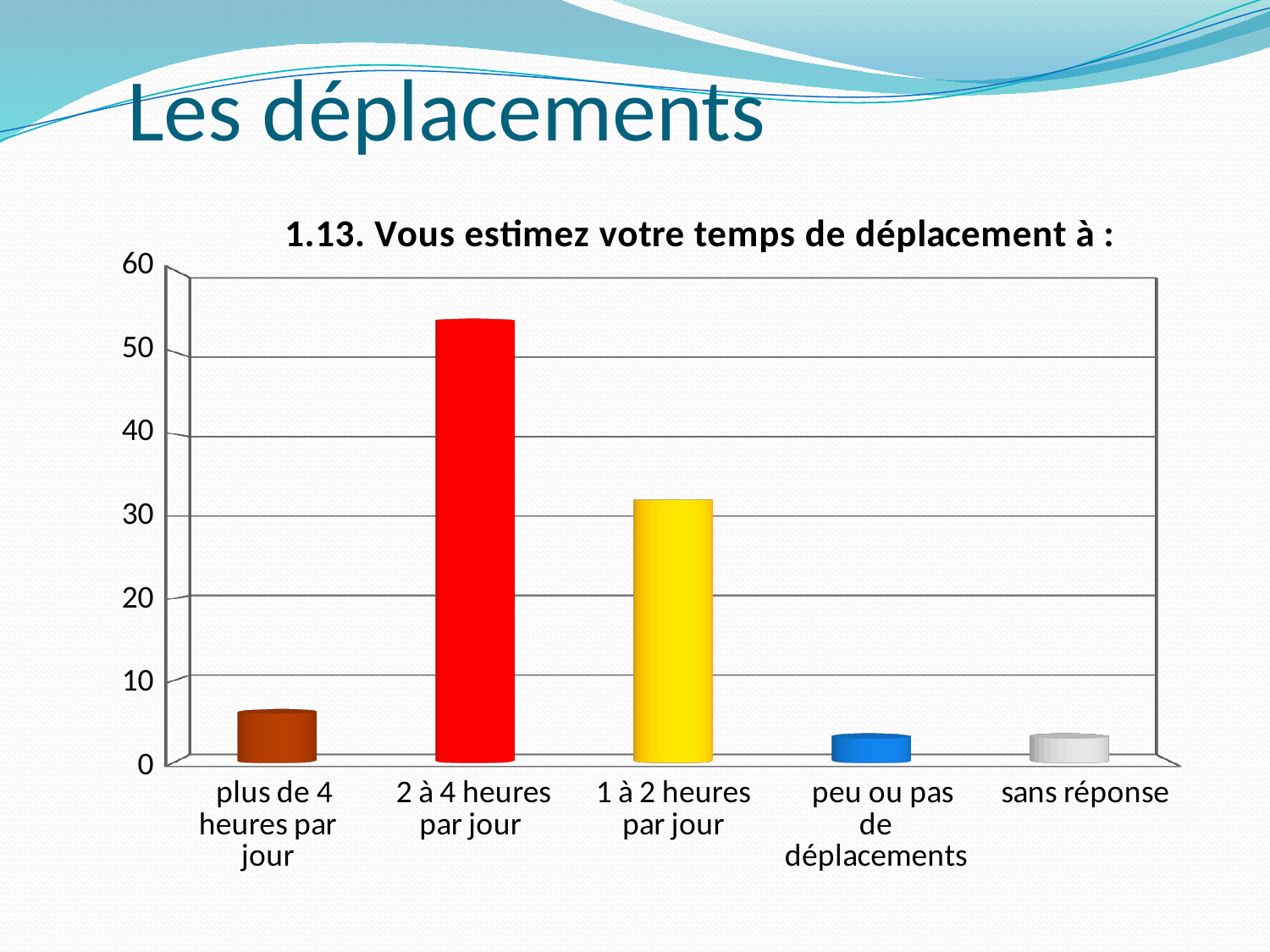
Is the value for "1 à 2 heures par jour" greater or less than 30? greater What is the title of the chart? 1.13. Vous estimez votre temps de déplacement à : Which category has the highest value? 2 à 4 heures par jour Is the value for "peu ou pas de déplacements" greater or less than 10? less Is the value for "2 à 4 heures par jour" greater or less than 50? greater Which is larger, the value for "2 à 4 heures par jour" or the value for "1 à 2 heures par jour"? 2 à 4 heures par jour What colour is the bar for "2 à 4 heures par jour"? red How many categories are shown on the x axis of the chart? 5 What kind of chart is shown on the slide? bar chart Which is larger, the value for "plus de 4 heures par jour" or the value for "1 à 2 heures par jour"? 1 à 2 heures par jour